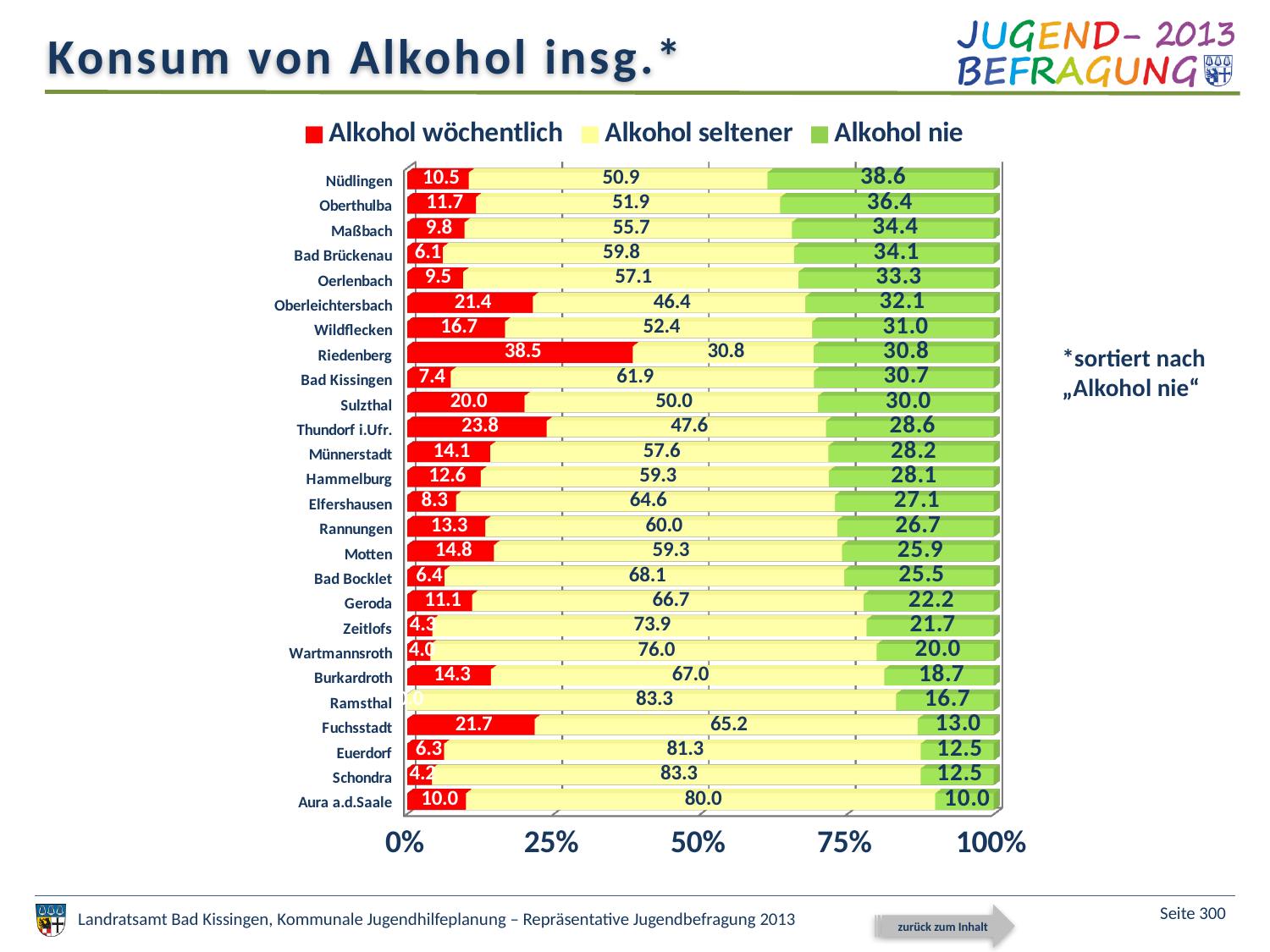
What is the difference between the "Alkohol nie" values for Nüdlingen and Oberthulba? 2.2 What is the value for "Alkohol nie" in Nüdlingen? 38.6 What is the value for "Alkohol wöchentlich" in Riedenberg? 38.5 Which municipality has the highest value for "Alkohol nie"? Nüdlingen Which municipality has the highest value for "Alkohol wöchentlich"? Riedenberg How many municipalities are shown in the chart? 26 How many series does the legend list? 3 According to the note on the slide, by which series are the bars sorted? Alkohol nie Which municipality has the lowest value for "Alkohol nie"? Aura a.d.Saale What is the value for "Alkohol seltener" in Ramsthal? 83.3 Which is larger: the "Alkohol wöchentlich" value for Thundorf i.Ufr. or for Fuchsstadt? Thundorf i.Ufr. What kind of chart is shown on the slide? Stacked bar chart